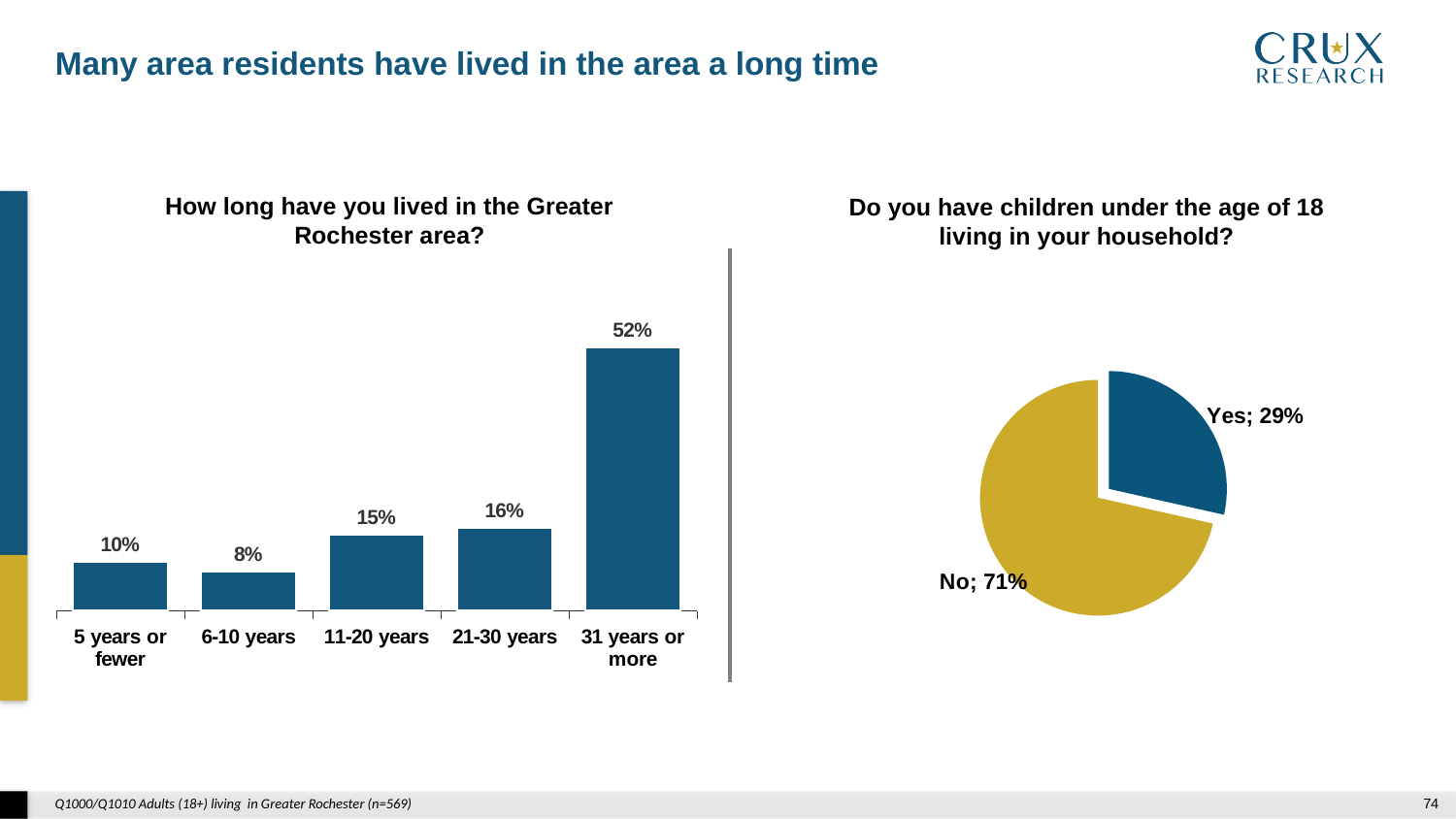
In the chart titled "Do you have children under the age of 18 living in your household?", what percentage answered Yes? 29% In the chart titled "Do you have children under the age of 18 living in your household?", what colour is the No slice? Gold In the chart titled "Do you have children under the age of 18 living in your household?", what is the difference between the No and Yes shares? 42% In the chart titled "How long have you lived in the Greater Rochester area?", which category has the lowest value? 6-10 years What kind of chart is the chart titled "Do you have children under the age of 18 living in your household?"? Pie chart In the chart titled "How long have you lived in the Greater Rochester area?", what is the value for 6-10 years? 8% In the chart titled "How long have you lived in the Greater Rochester area?", which is larger: the value for 5 years or fewer or the value for 11-20 years? 11-20 years How many categories are shown in the chart titled "How long have you lived in the Greater Rochester area?"? 5 What kind of chart is the chart titled "How long have you lived in the Greater Rochester area?"? Bar chart In the chart titled "How long have you lived in the Greater Rochester area?", which category has the highest value? 31 years or more In the chart titled "How long have you lived in the Greater Rochester area?", what is the difference between the values for 31 years or more and 21-30 years? 36% In the chart titled "How long have you lived in the Greater Rochester area?", what percentage of respondents have lived in the area 31 years or more? 52%